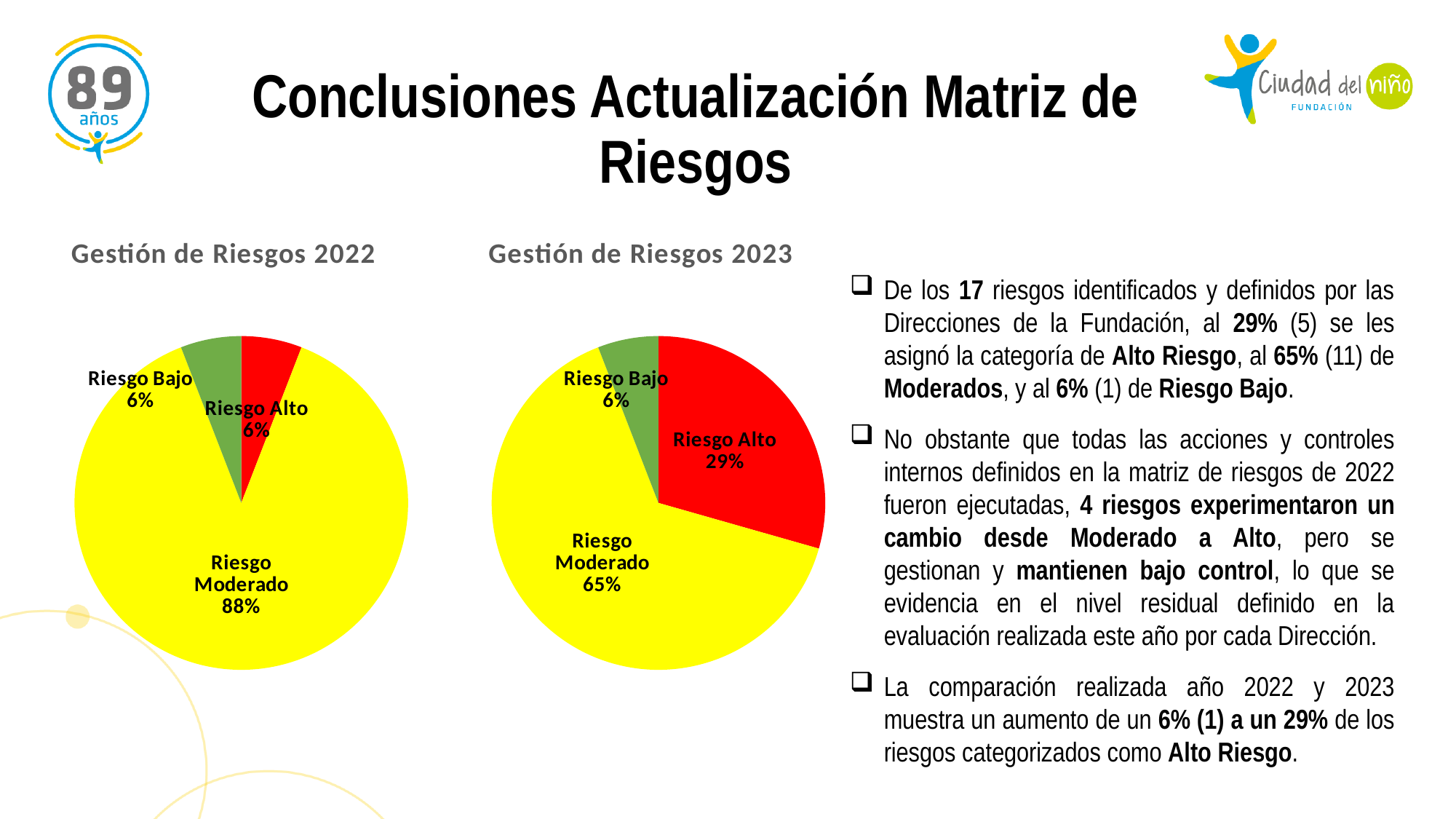
In the 'Gestión de Riesgos 2023' chart, what is the value for Riesgo Bajo? 6% In the 'Gestión de Riesgos 2023' chart, what is the difference between Riesgo Moderado and Riesgo Alto? 36% How many categories does the 'Gestión de Riesgos 2022' chart show? 3 In the 'Gestión de Riesgos 2022' chart, what colour is the Riesgo Moderado slice? Yellow In the 'Gestión de Riesgos 2023' chart, which category has the largest slice? Riesgo Moderado In the 'Gestión de Riesgos 2023' chart, which is larger, Riesgo Alto or Riesgo Bajo? Riesgo Alto In the 'Gestión de Riesgos 2023' chart, which category has the smallest slice? Riesgo Bajo In the 'Gestión de Riesgos 2023' chart, what share does Riesgo Alto have? 29% What kind of chart is 'Gestión de Riesgos 2023'? Pie chart In the 'Gestión de Riesgos 2022' chart, what share does Riesgo Moderado have? 88% In the 'Gestión de Riesgos 2022' chart, what is the value for Riesgo Alto? 6% What is the difference between the Riesgo Alto share in the 2023 chart and the Riesgo Alto share in the 2022 chart? 23%